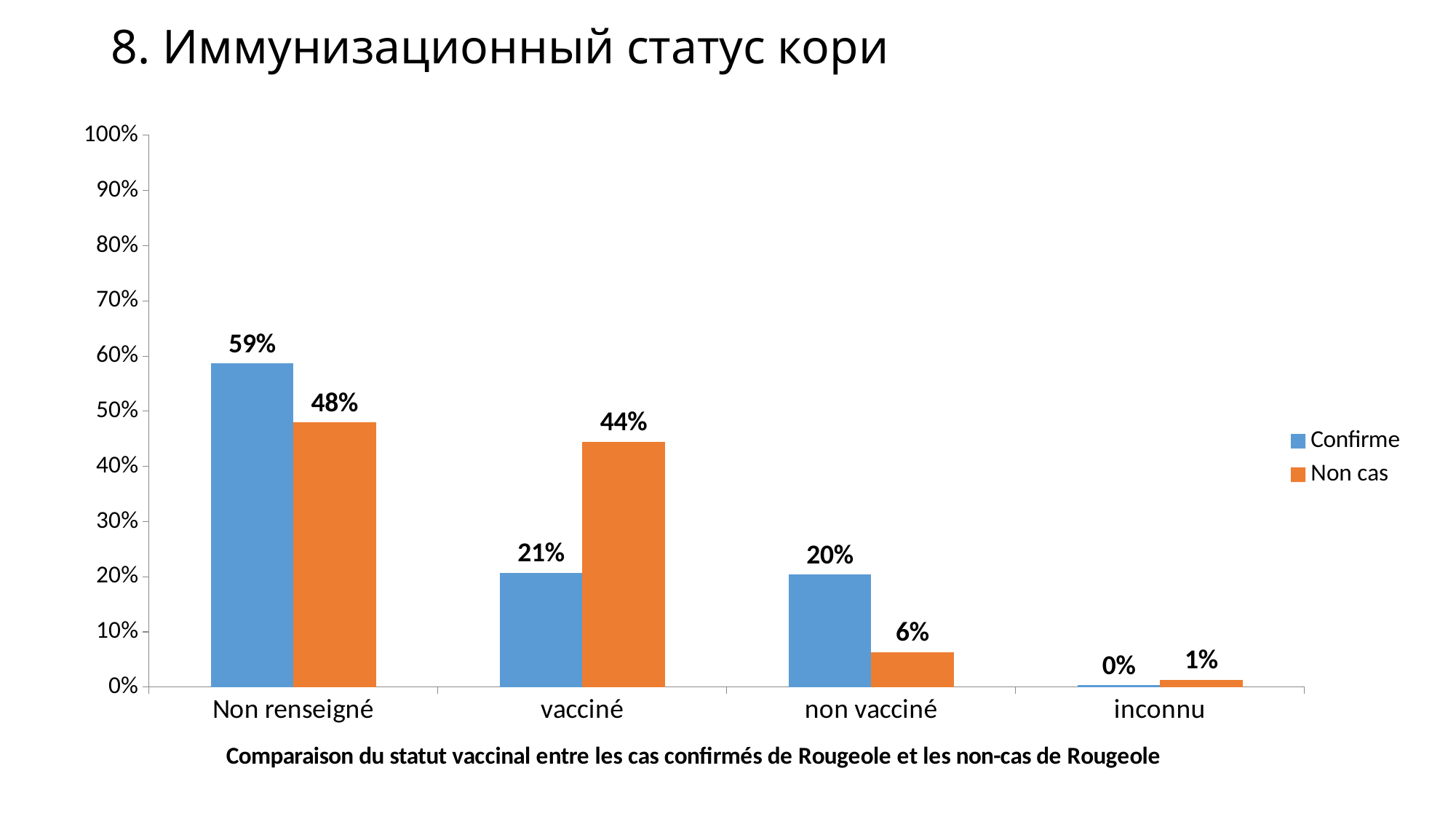
How many categories are shown on the x axis? 4 What is the difference between the Confirme and Non cas values in the non vacciné category? 14% What is the value for Non cas in the vacciné category? 44% What kind of chart is shown on the slide? Bar chart In the vacciné category, which series has the larger value, Confirme or Non cas? Non cas What colour are the bars for the Non cas series? Orange How many series does the legend list? 2 Which category has the lowest value for the Confirme series? inconnu What is the value for Confirme in the inconnu category? 0% What is the value for Non cas in the non vacciné category? 6% What is the value for Confirme in the Non renseigné category? 59% Which category has the highest value for the Non cas series? Non renseigné